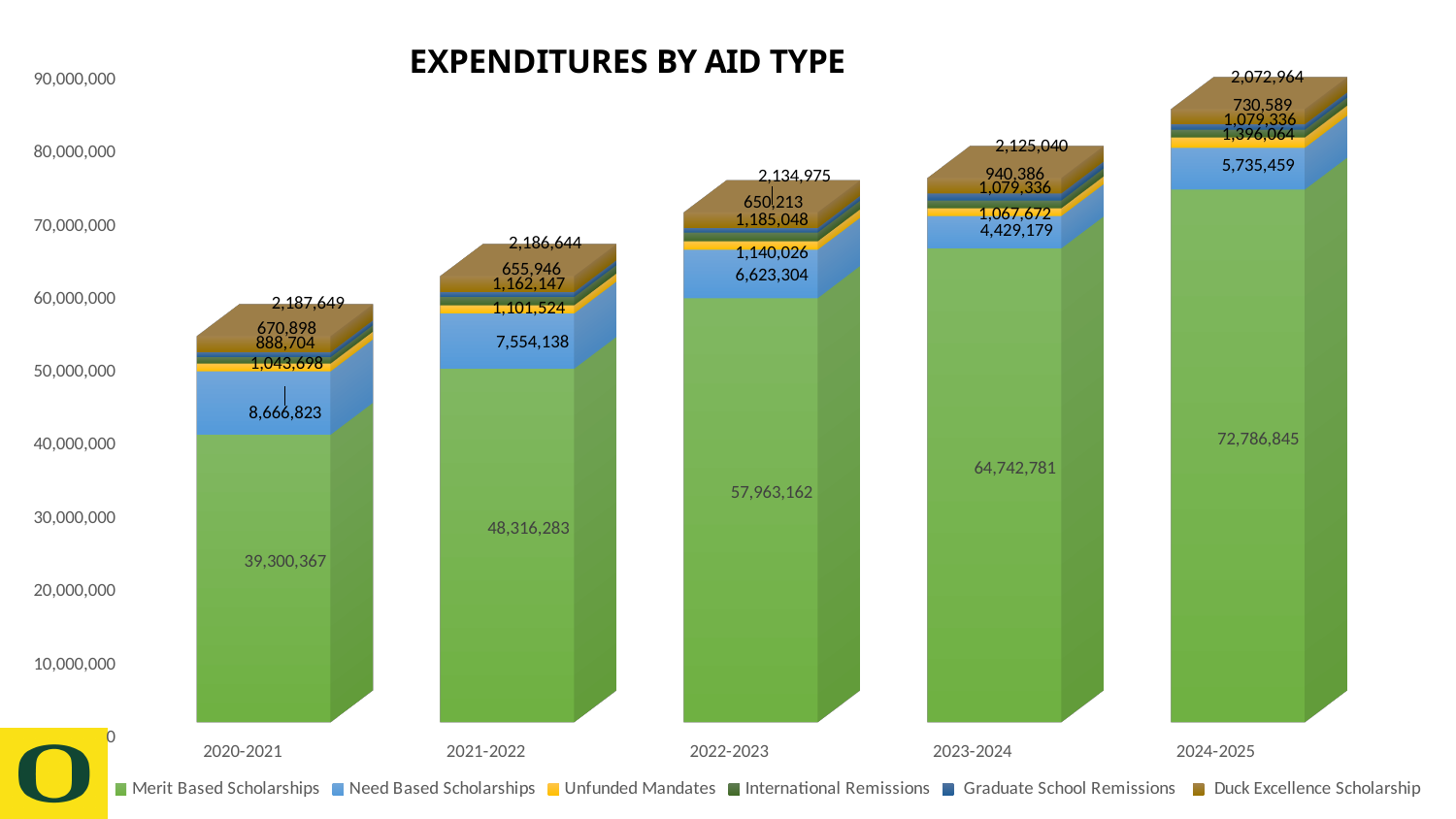
Which is larger, the Need Based Scholarships value for 2020-2021 or for 2021-2022? 2020-2021 What is the Merit Based Scholarships value for 2024-2025? 72,786,845 What is the Duck Excellence Scholarship value for 2022-2023? 2,134,975 What kind of chart is this? Stacked bar chart What is the difference between the Merit Based Scholarships values for 2024-2025 and 2020-2021? 33,486,478 What is the Merit Based Scholarships value for 2021-2022? 48,316,283 Which year has the highest Merit Based Scholarships value? 2024-2025 Do the Merit Based Scholarships values rise or fall from 2020-2021 to 2024-2025? Rise How many years are shown on the x axis? 5 Which year has the lowest Need Based Scholarships value? 2023-2024 What is the Need Based Scholarships value for 2020-2021? 8,666,823 How many series does the legend list? 6